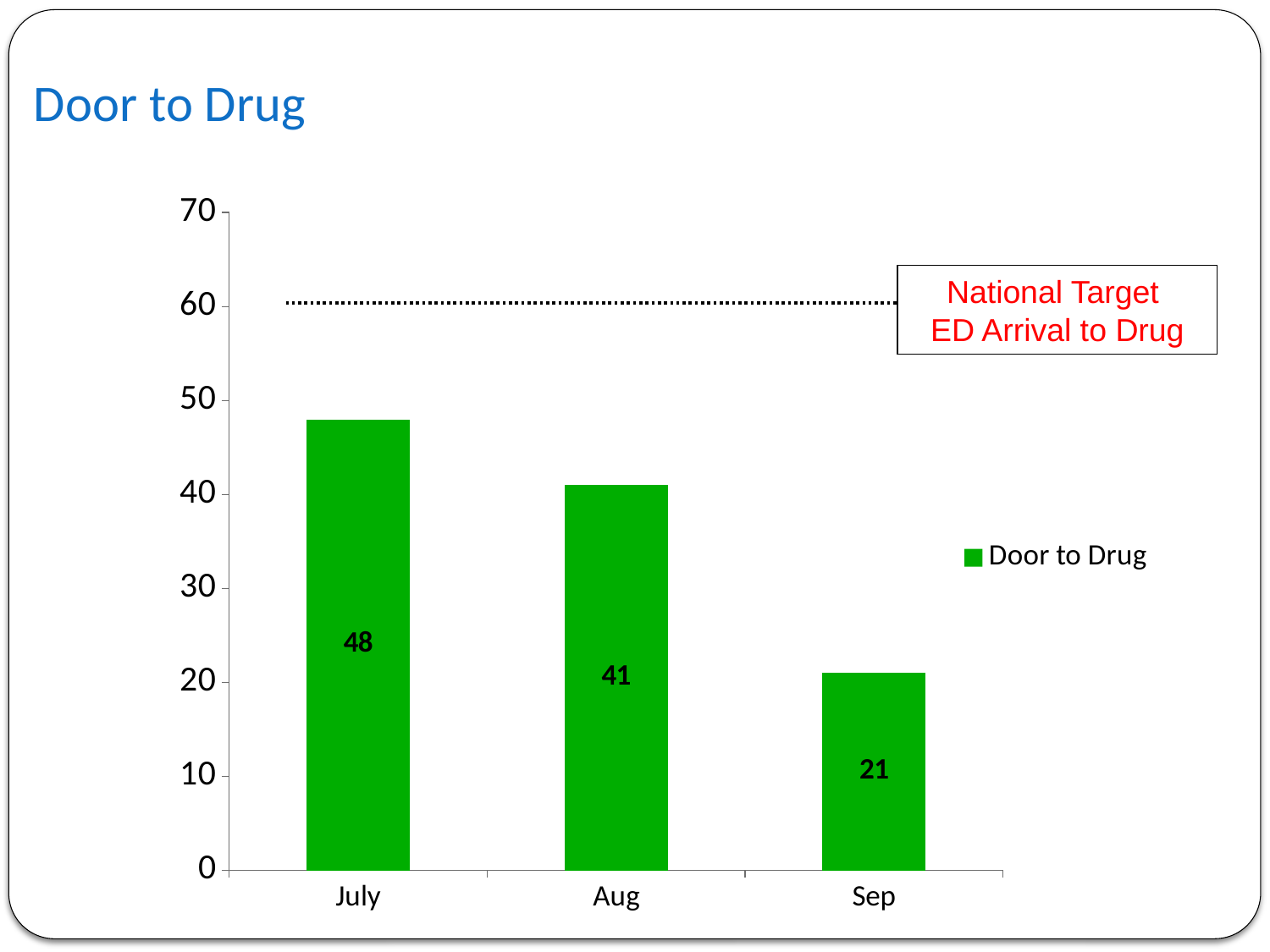
What is the Door to Drug value for Aug? 41 What is the Door to Drug value for July? 48 Which month has the highest Door to Drug value? July How many months are shown on the x axis? 3 What is the difference between the July and Sep Door to Drug values? 27 What is the Door to Drug value for Sep? 21 What kind of chart is shown on the slide? bar chart Which is larger, the Door to Drug value for Aug or for Sep? Aug Is the Door to Drug value for Sep greater or less than 30? less Which month has the lowest Door to Drug value? Sep Do the Door to Drug values rise or fall from July to Sep? fall What is the difference between the July and Aug Door to Drug values? 7